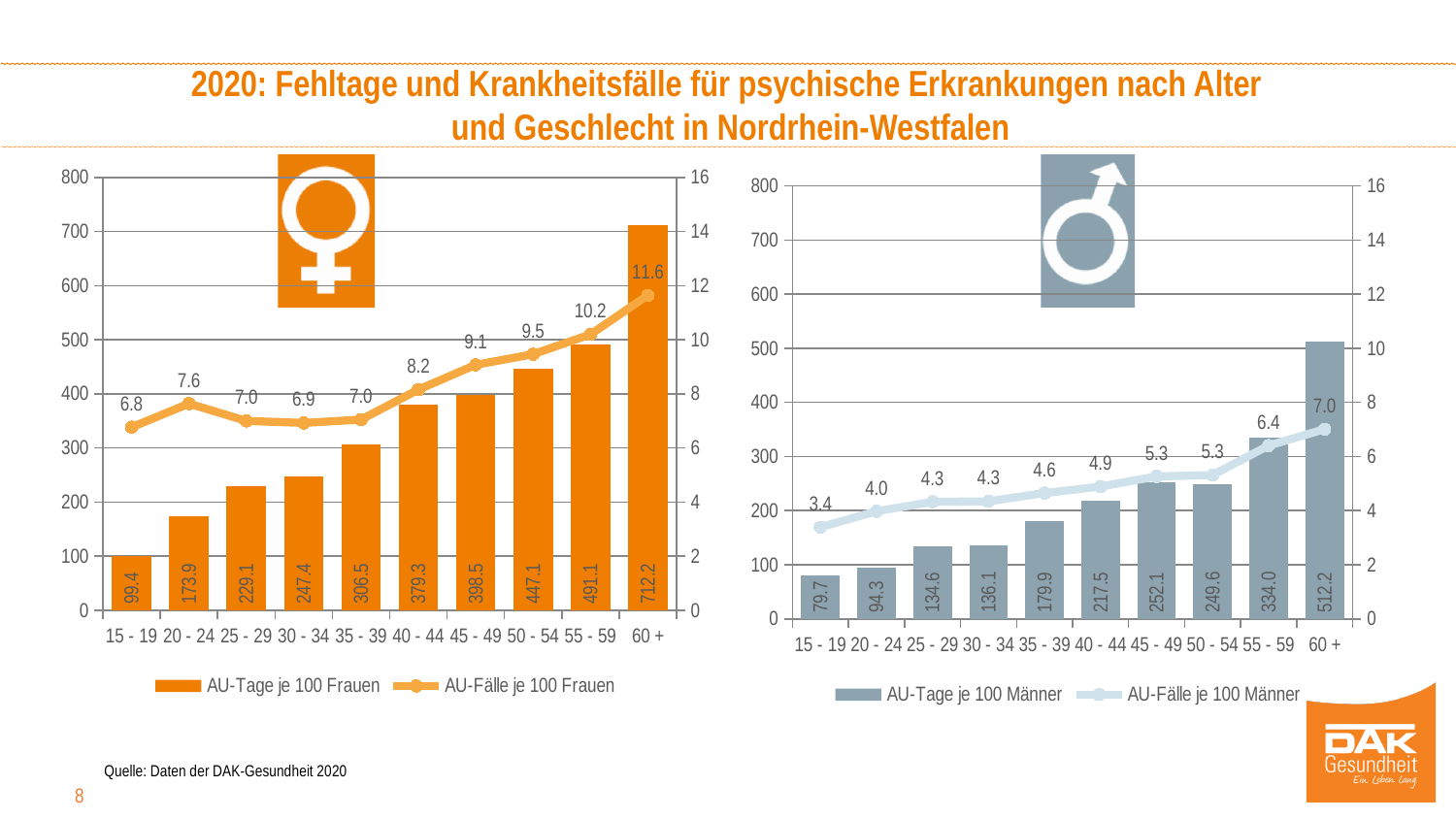
In the left chart (Frauen), what is the value of AU-Tage je 100 Frauen for the 60 + age group? 712.2 How many age groups are shown on the x axis of the left chart (Frauen)? 10 In the right chart (Männer), what is the value of AU-Fälle je 100 Männer for the 15 - 19 age group? 3.4 What is the title of the slide? 2020: Fehltage und Krankheitsfälle für psychische Erkrankungen nach Alter und Geschlecht in Nordrhein-Westfalen In the right chart (Männer), do the values of AU-Fälle je 100 Männer generally rise or fall from 15 - 19 to 60 +? rise How many series does the legend of the right chart (Männer) list? 2 In the right chart (Männer), which is larger: AU-Tage je 100 Männer for 45 - 49 or for 50 - 54? 45 - 49 In the left chart (Frauen), which age group has the lowest value of AU-Tage je 100 Frauen? 15 - 19 In the left chart (Frauen), what is the difference between AU-Tage je 100 Frauen for 60 + and for 55 - 59? 221.1 In the right chart (Männer), is the value of AU-Tage je 100 Männer for 60 + greater or less than 500? greater In the right chart (Männer), which age group has the highest value of AU-Tage je 100 Männer? 60 + What kind of chart is the left chart (Frauen)? Combined bar and line chart